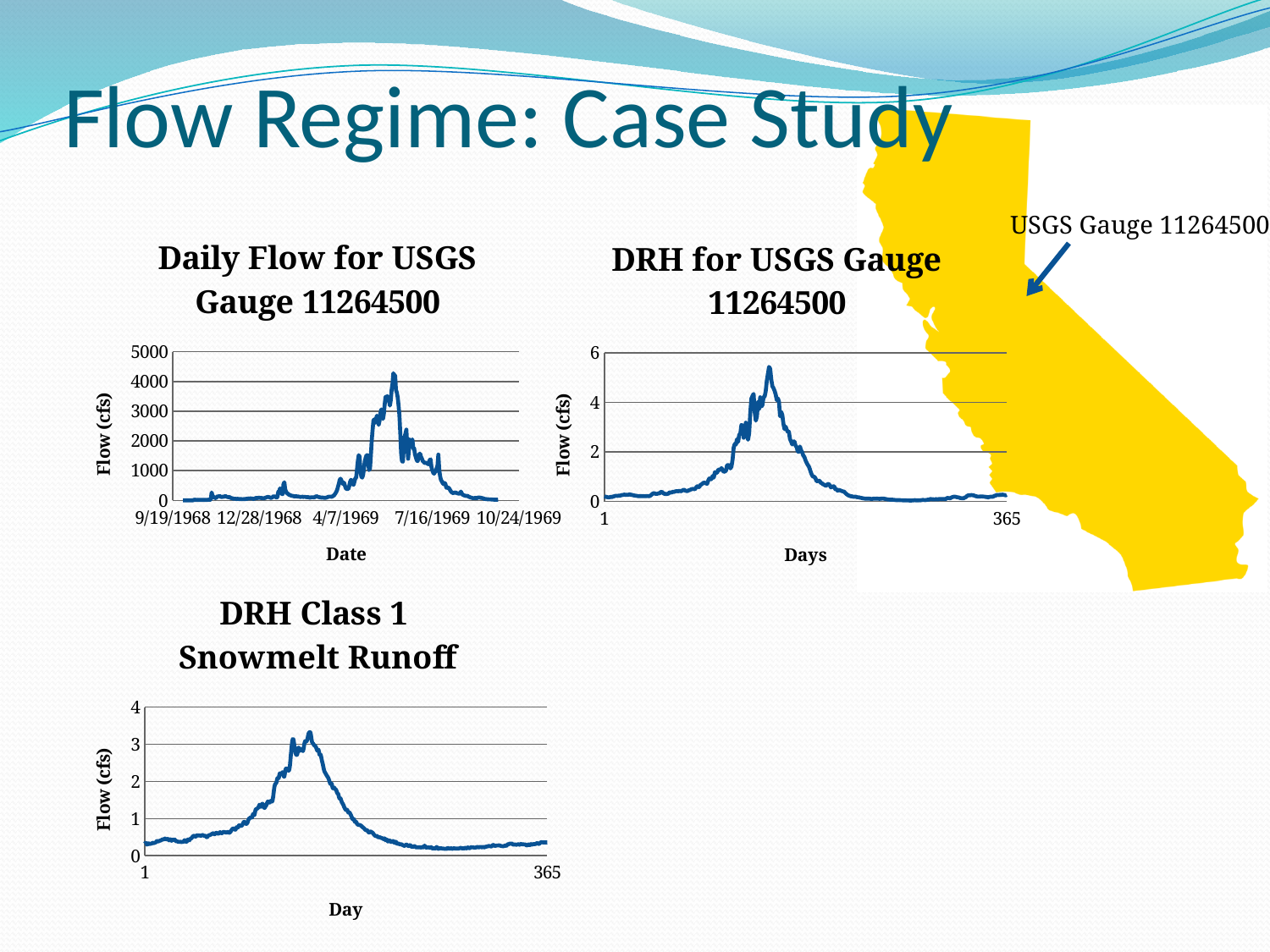
How many charts are shown on the slide? 3 In the 'DRH Class 1 Snowmelt Runoff' chart, is the peak value greater or less than 3? greater In the 'DRH Class 1 Snowmelt Runoff' chart, is the peak value greater or less than 4? less In the 'DRH for USGS Gauge 11264500' chart, is the peak value greater or less than 4? greater What kind of chart is the 'Daily Flow for USGS Gauge 11264500' chart? line chart What is the highest tick value on the y axis of the 'Daily Flow for USGS Gauge 11264500' chart? 5000 In the 'DRH Class 1 Snowmelt Runoff' chart, do the values rise or fall from the peak toward day 365? fall What is the x-axis label of the 'DRH Class 1 Snowmelt Runoff' chart? Day